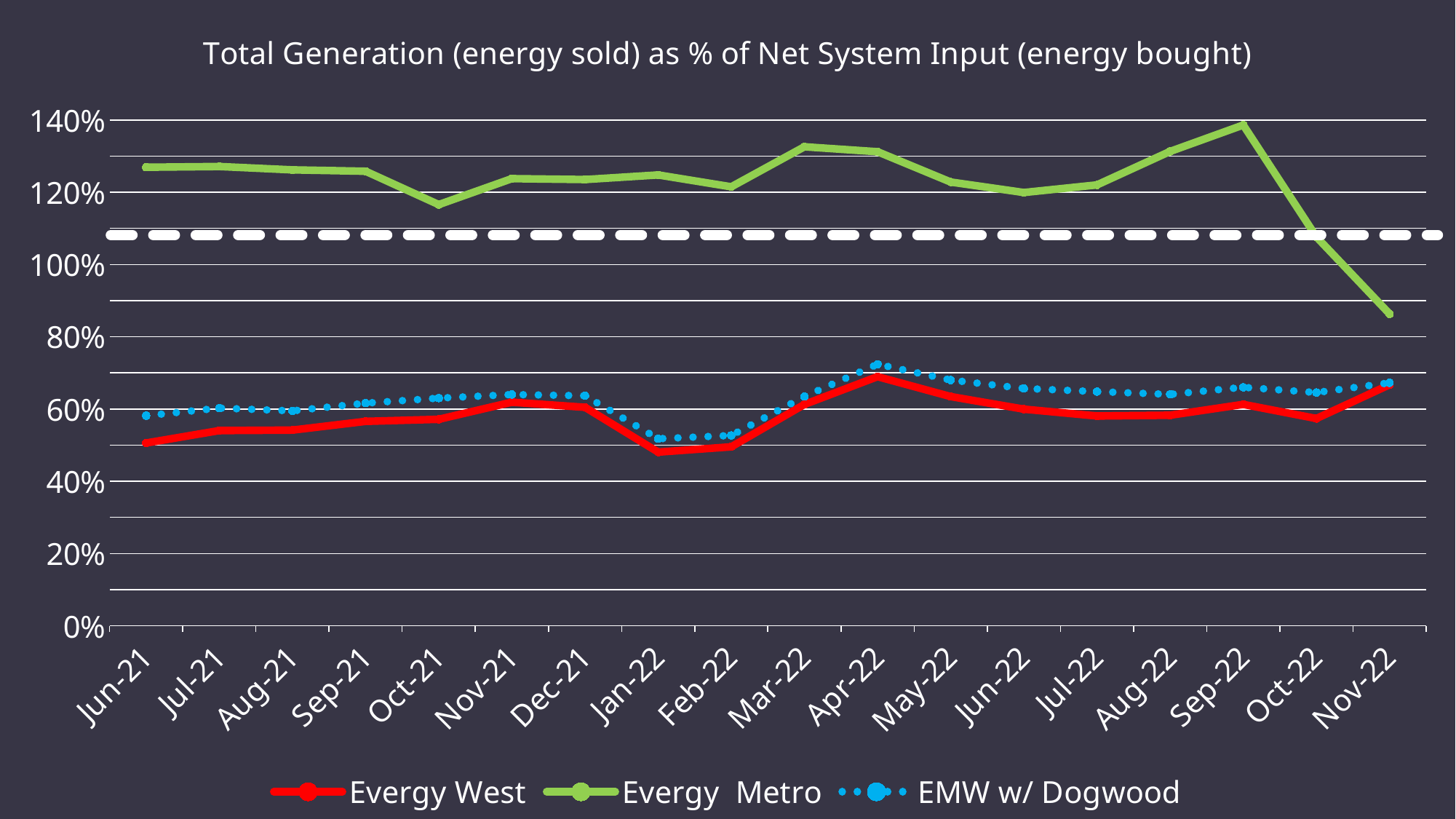
Is the Evergy West value for Jan-22 greater or less than 60%? less Does the Evergy Metro series rise or fall from Sep-22 to Nov-22? fall How many months are plotted along the x axis? 18 In which month does the Evergy West series reach its lowest value? Jan-22 In which month does the Evergy West series reach its highest value? Apr-22 How many series does the legend list? 3 Is the Evergy Metro value for Nov-22 greater or less than 100%? less What kind of chart is shown on the slide? line chart What is the title of the chart? Total Generation (energy sold) as % of Net System Input (energy bought) In which month does the Evergy Metro series reach its highest value? Sep-22 Which series has the larger value in Jun-21, Evergy West or Evergy Metro? Evergy Metro In which month does the Evergy Metro series reach its lowest value? Nov-22